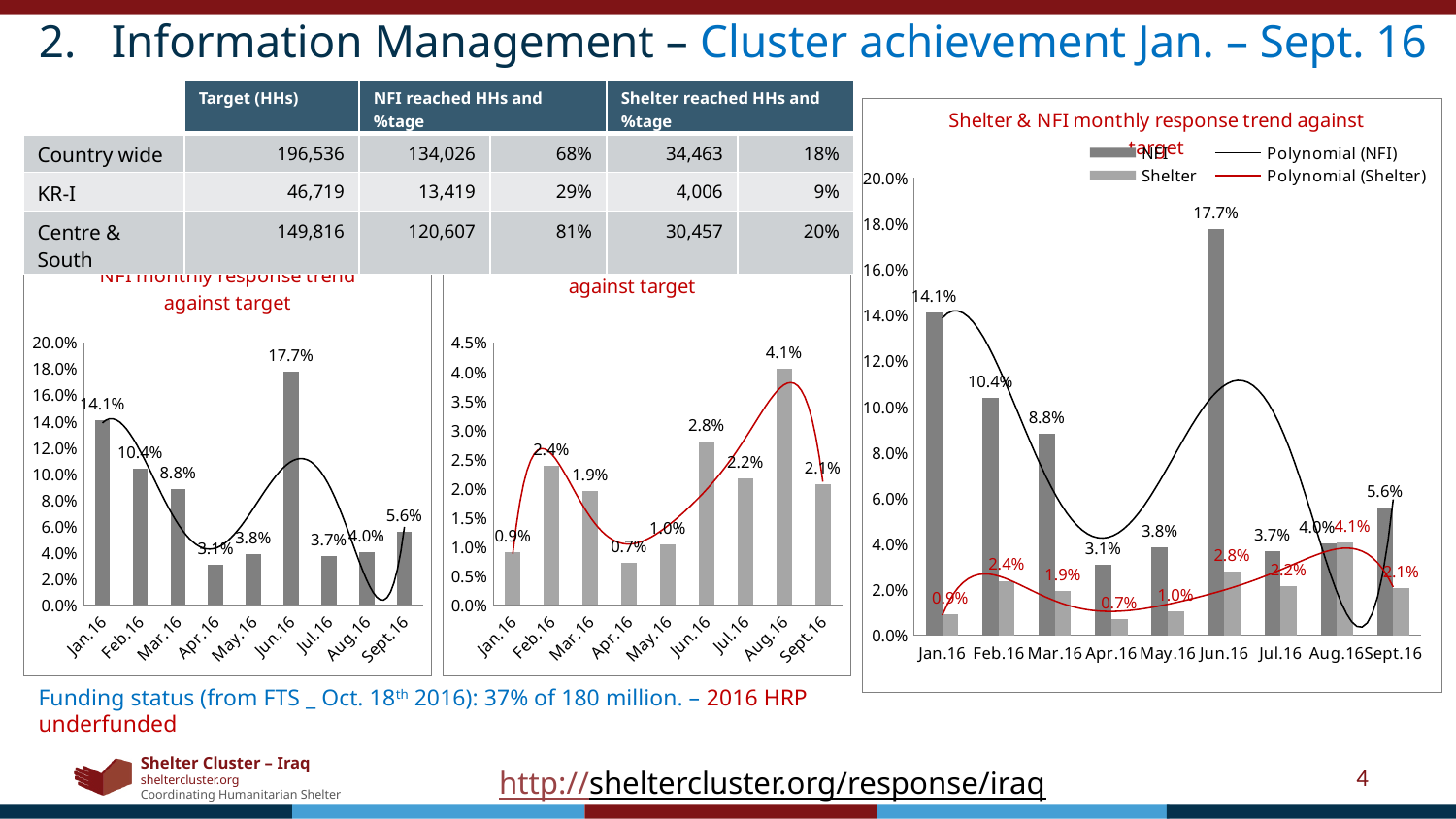
In the bottom-middle shelter chart, what is the difference between the Jun.16 and Jul.16 values? 0.6% In the 'NFI monthly response trend against target' chart, what is the value for Jun.16? 17.7% In the 'Shelter & NFI monthly response trend against target' chart, how many entries does the legend list? 4 In the bottom-middle shelter chart, which month has the lowest value? Apr.16 In the 'NFI monthly response trend against target' chart, which month has the lowest value? Apr.16 What kind of chart is the 'NFI monthly response trend against target' chart? Bar chart In the 'Shelter & NFI monthly response trend against target' chart, what is the Shelter value for Sept.16? 2.1% In the 'NFI monthly response trend against target' chart, which month has the highest value? Jun.16 In the bottom-middle shelter chart, which is larger, the value for Feb.16 or the value for Jun.16? Jun.16 In the 'NFI monthly response trend against target' chart, how many months are plotted? 9 In the 'NFI monthly response trend against target' chart, what is the difference between the Jan.16 and Feb.16 values? 3.7% In the bottom-middle shelter chart, what is the value for Aug.16? 4.1%